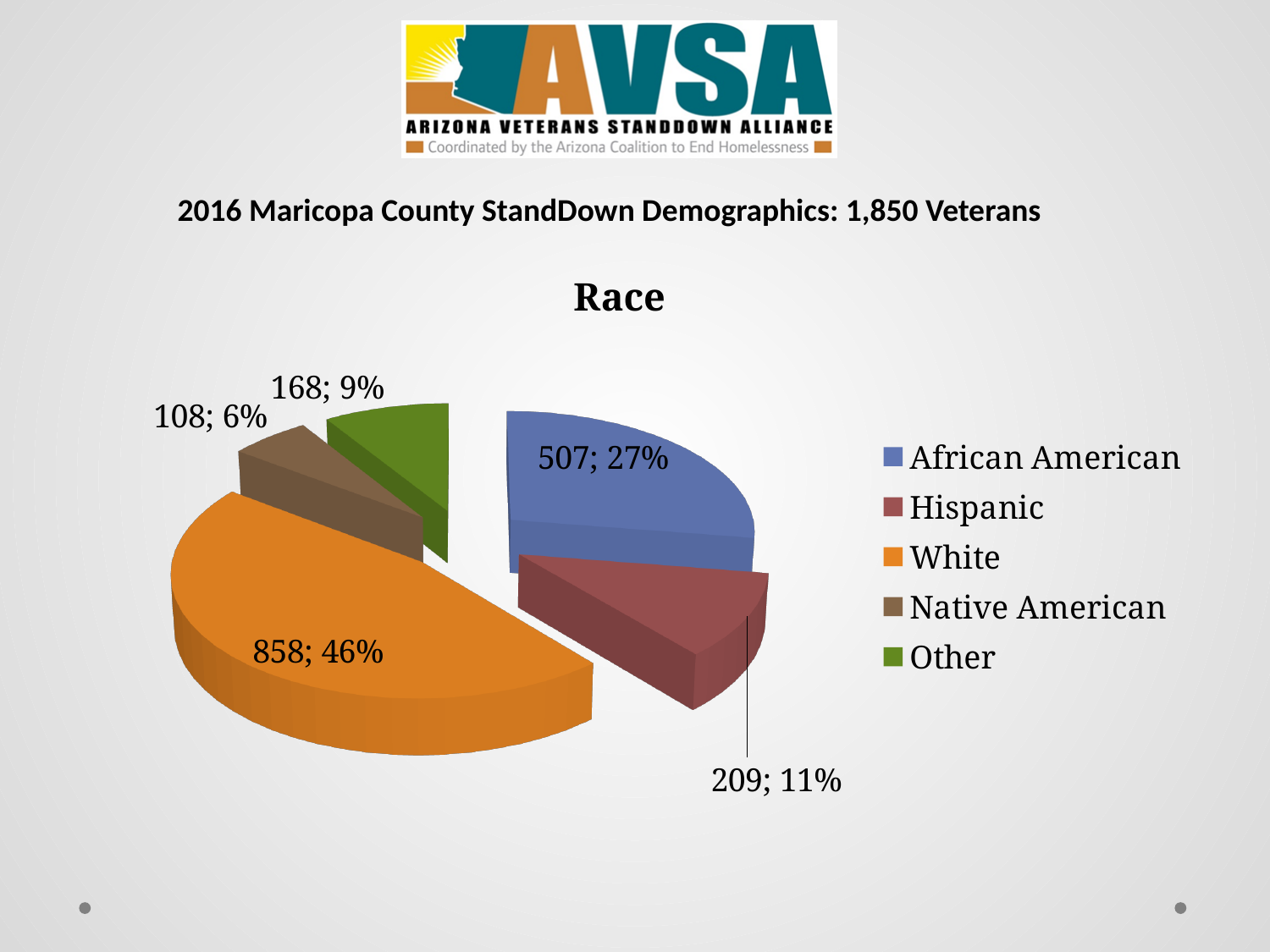
What share of the pie is the Native American slice? 6% How many categories does the pie chart show? 5 What is the title of the pie chart? Race What is the difference in count between the White and African American categories? 351 Which category has the largest slice of the pie? White How many veterans are in the Hispanic category? 209 Which is larger, the Other slice or the Hispanic slice? Hispanic What percentage of the pie does the African American slice represent? 27% How many veterans are in the White category? 858 What colour is the Other slice in the pie chart? Green What type of chart is shown on the slide? Pie chart Which category has the smallest slice of the pie? Native American